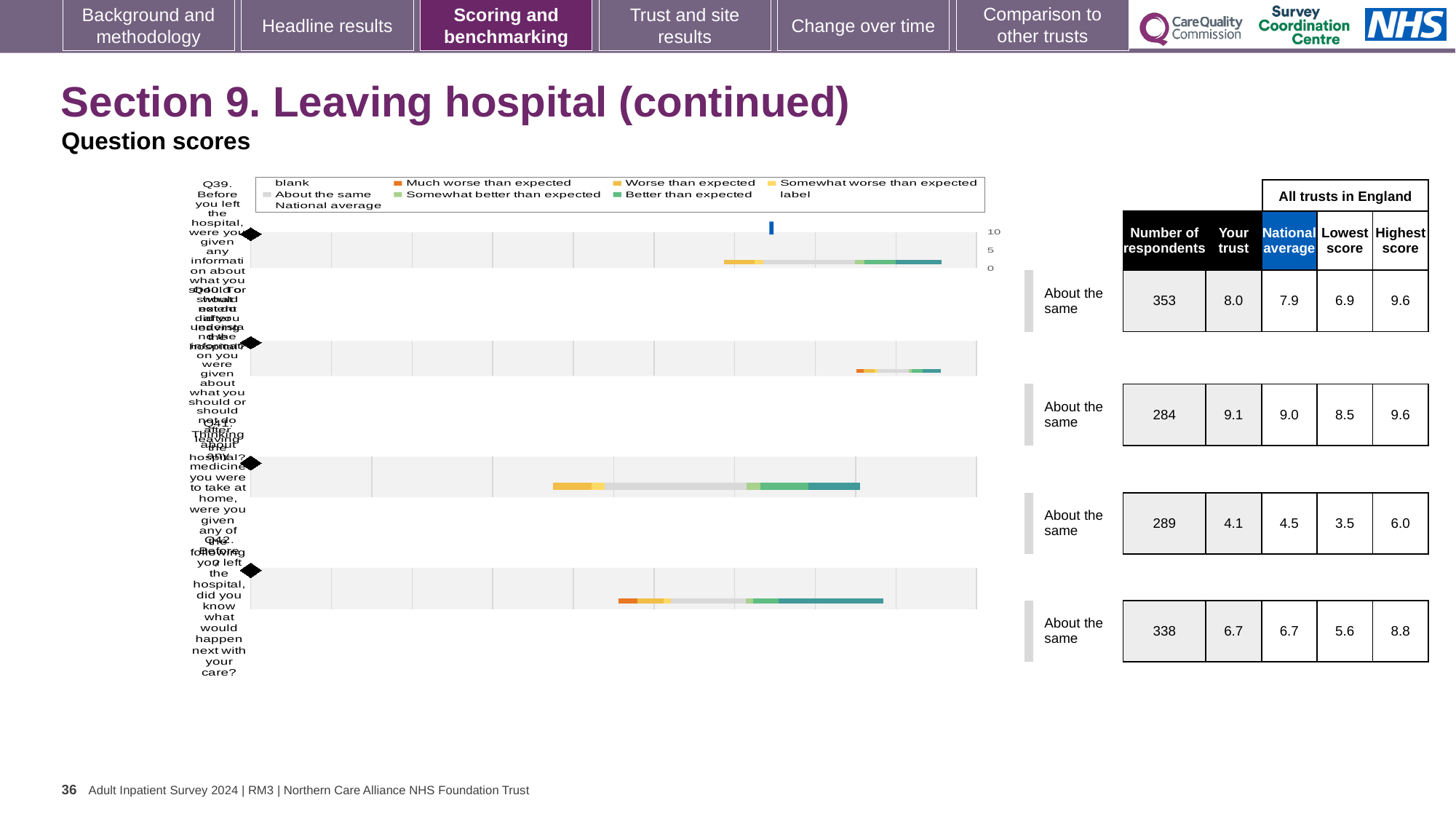
In the table beside the chart, what is the difference between the 'Your trust' score and the national average for the second row (Q40)? 0.1 Which legend entry is shown in dark teal? Better than expected How many question bars are plotted in the chart? 4 What benchmark label is shown next to each bar in the chart? About the same In the table beside the chart, what is the number of respondents for Q39 (the first row)? 353 Which colour does the legend use for 'Much worse than expected'? orange In the table beside the chart, which row has the lowest 'Your trust' score? Q41 (third row), 4.1 In the table beside the chart, which row has the highest number of respondents? Q39 (first row), 353 In the table beside the chart, what is the 'Your trust' score for Q39 (the first row)? 8.0 What kind of chart is shown on the slide? bar chart In the table beside the chart, what is the national average for Q42 (the last row)? 6.7 In the table beside the chart, what is the highest score for the third row (Q41)? 6.0